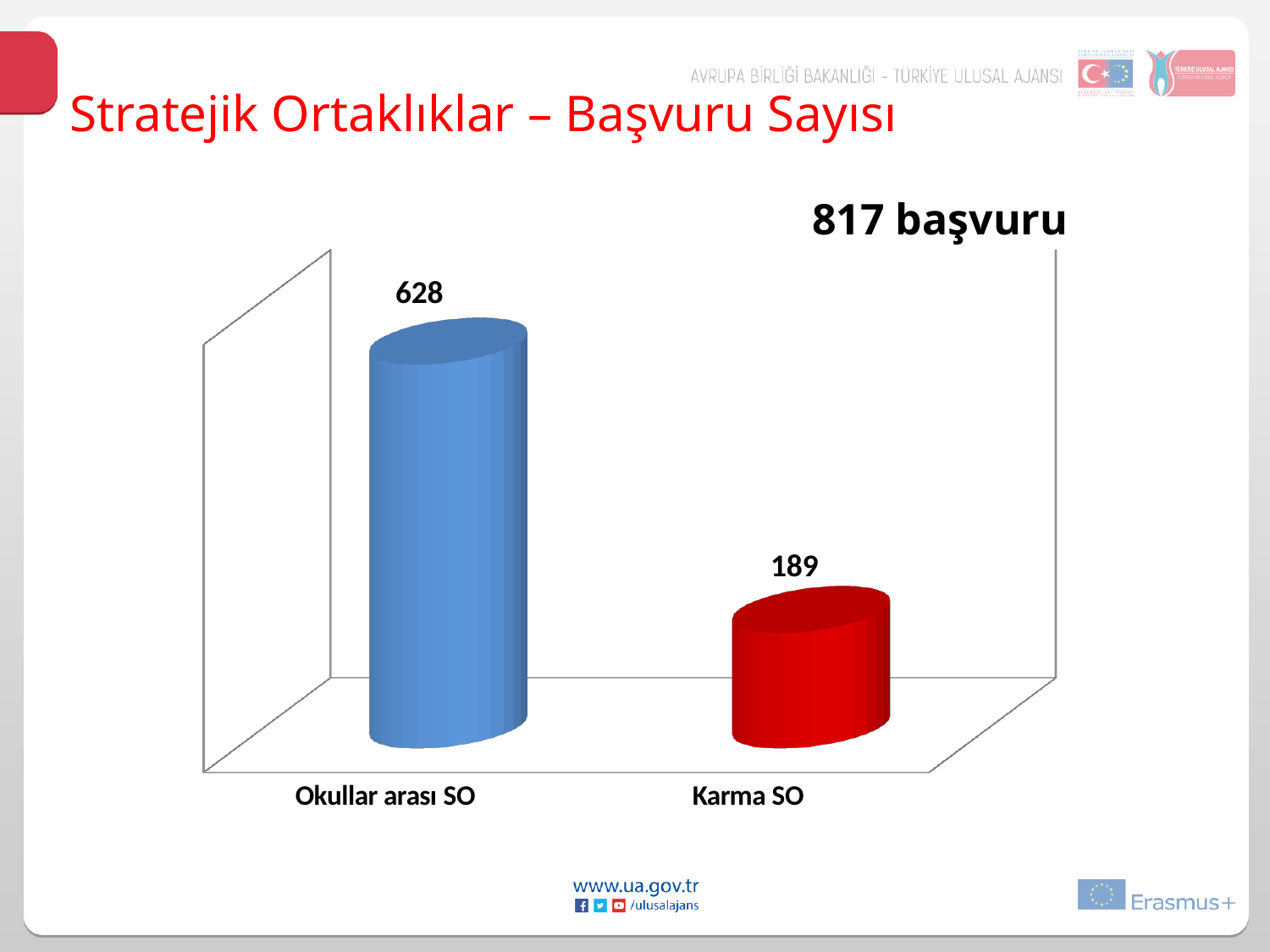
What is the title of the slide? Stratejik Ortaklıklar – Başvuru Sayısı What kind of chart is shown on the slide? Bar chart What is the difference between the values for Okullar arası SO and Karma SO? 439 What is the total of the two values shown in the chart? 817 How many categories are shown in the chart? 2 Which category has the highest value? Okullar arası SO What is the value for Okullar arası SO? 628 Which is larger, the value for Okullar arası SO or the value for Karma SO? Okullar arası SO Which category has the lowest value? Karma SO What colour is the bar for Karma SO? Red What is the value for Karma SO? 189